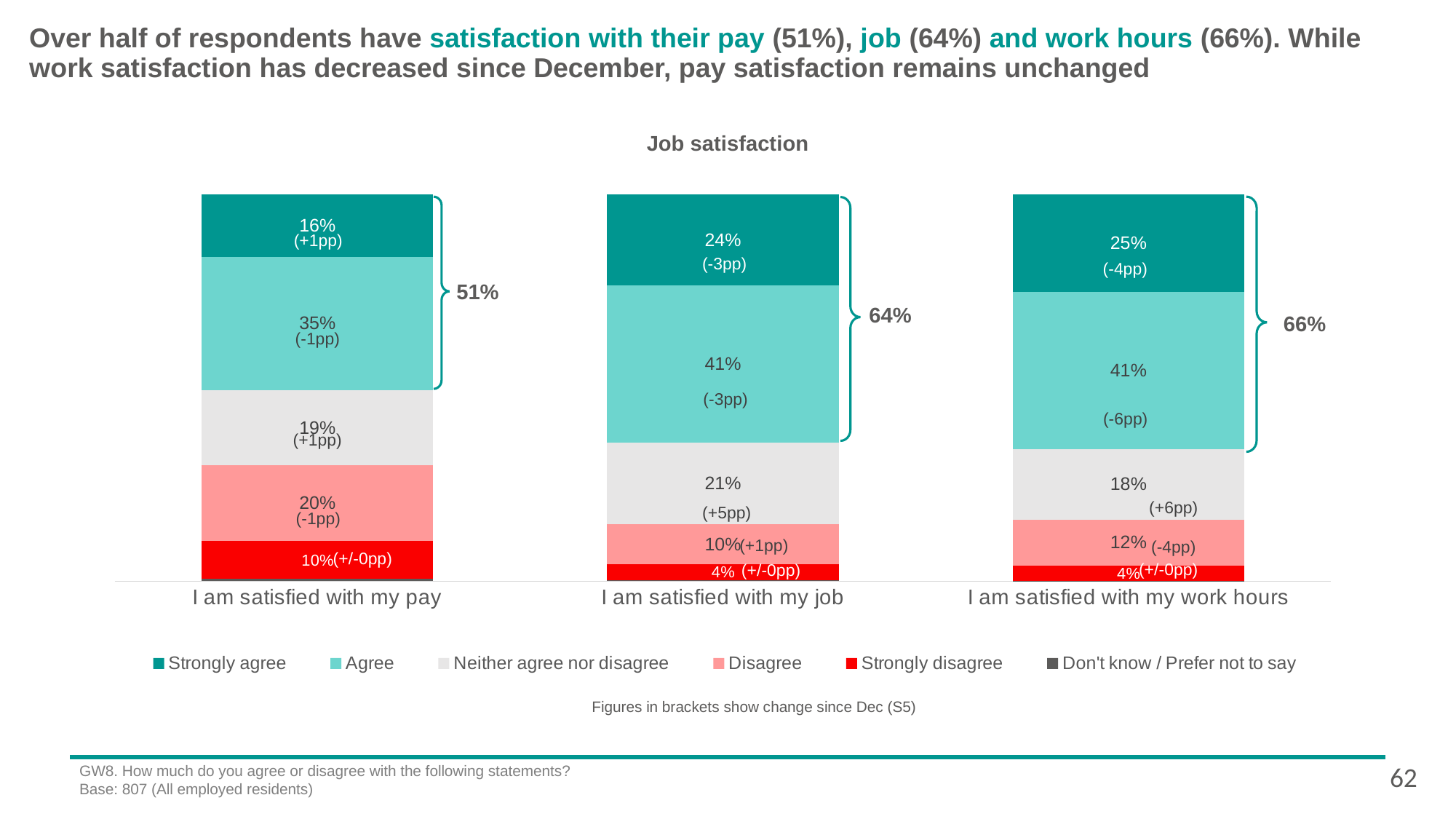
What percentage of respondents strongly agree with "I am satisfied with my pay"? 16% How much higher is the Agree share for "I am satisfied with my job" than for "I am satisfied with my pay"? 6 percentage points Which statement has the highest share of respondents who strongly agree? I am satisfied with my work hours What percentage of respondents strongly disagree with "I am satisfied with my job"? 4% Which has a larger Neither agree nor disagree share: "I am satisfied with my pay" or "I am satisfied with my job"? I am satisfied with my job What percentage of respondents agree with "I am satisfied with my job"? 41% How many series does the legend list? 6 What is the combined share of Strongly agree and Agree for "I am satisfied with my work hours"? 66% How many statements are shown on the chart? 3 What percentage of respondents neither agree nor disagree with "I am satisfied with my work hours"? 18% What kind of chart is shown on the slide? Stacked bar chart Which statement has the lowest share of respondents who disagree? I am satisfied with my job